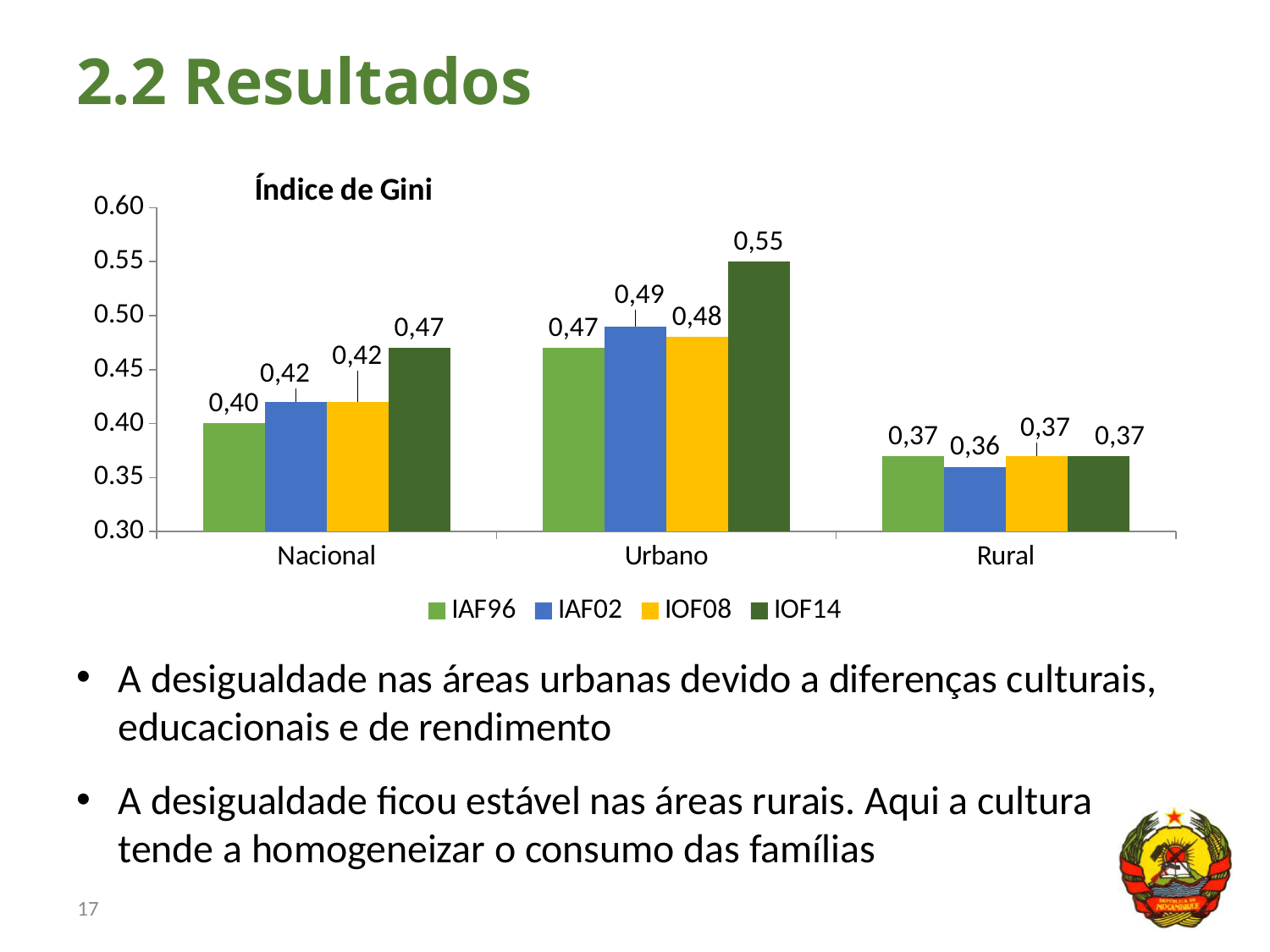
What is the IAF02 value for Rural? 0,36 How many series does the legend list? 4 Which category has the highest IOF14 value? Urbano What is the IAF96 value for Nacional? 0,40 What kind of chart is shown? bar chart Which category has the lowest IAF96 value? Rural What is the difference between the IOF14 and IAF96 values for Urbano? 0,08 Which is larger for Nacional: the IAF02 value or the IOF14 value? IOF14 What is the IOF14 value for Urbano? 0,55 Is the IOF14 value for Urbano greater or less than 0.50? greater What is the title of the chart? Índice de Gini How many categories are shown on the x axis? 3